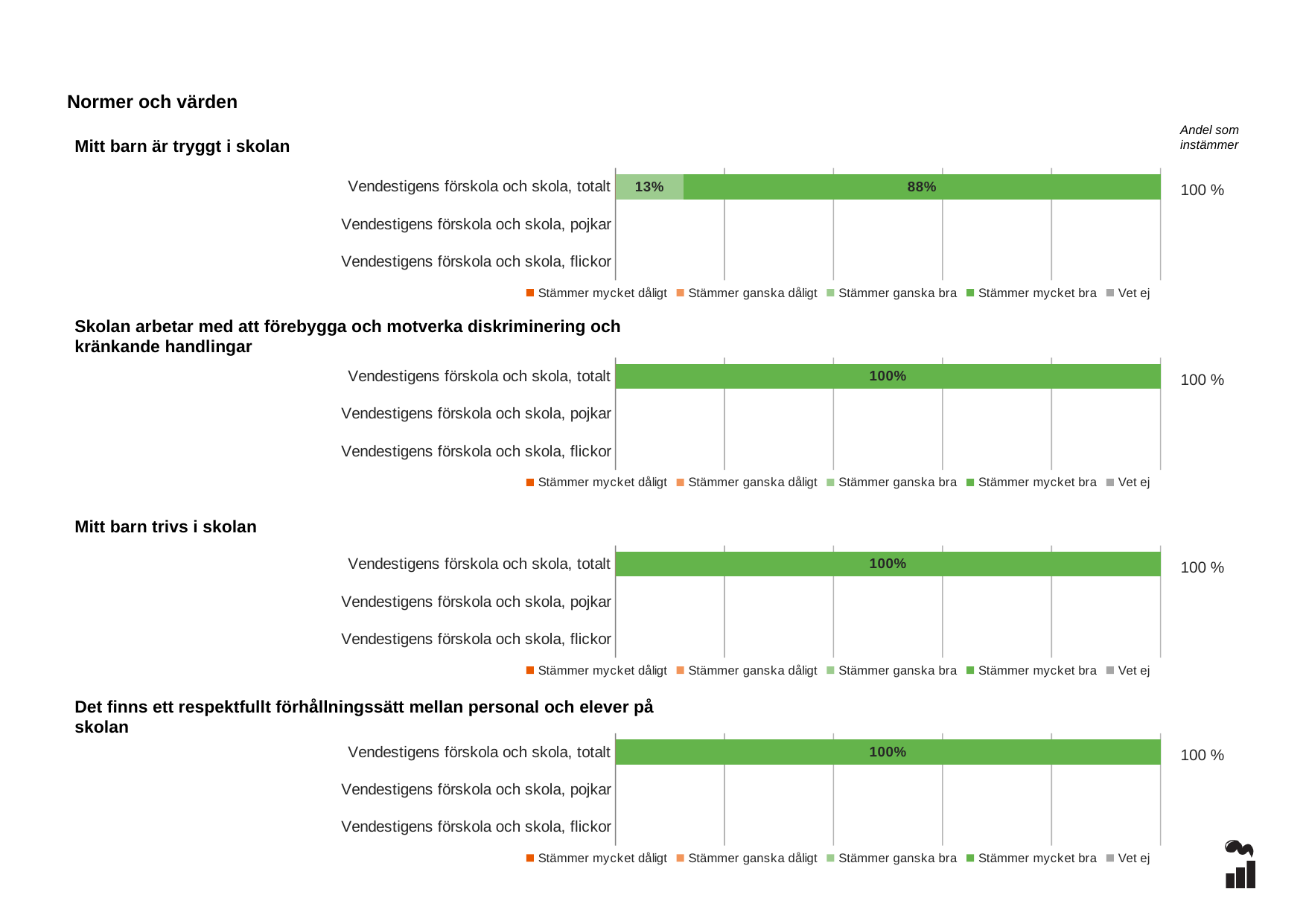
In the chart 'Mitt barn är tryggt i skolan', what is the difference in percentage points between 'Stämmer mycket bra' and 'Stämmer ganska bra' for the 'totalt' row? 75 percentage points In the chart 'Skolan arbetar med att förebygga och motverka diskriminering och kränkande handlingar', what percentage is shown for 'Vendestigens förskola och skola, totalt'? 100% What kind of chart is used for 'Mitt barn trivs i skolan'? Stacked horizontal bar chart In the chart 'Mitt barn trivs i skolan', what percentage is shown for 'Vendestigens förskola och skola, totalt'? 100% In the chart 'Mitt barn är tryggt i skolan', what percentage of 'Vendestigens förskola och skola, totalt' answered 'Stämmer ganska bra'? 13% In the chart 'Mitt barn är tryggt i skolan', for the 'totalt' row, which share is larger: 'Stämmer ganska bra' or 'Stämmer mycket bra'? Stämmer mycket bra How many charts are shown on the slide? 4 In the chart 'Mitt barn är tryggt i skolan', how many response categories does the legend list? 5 In the chart 'Mitt barn är tryggt i skolan', what percentage of 'Vendestigens förskola och skola, totalt' answered 'Stämmer mycket bra'? 88% In the chart 'Det finns ett respektfullt förhållningssätt mellan personal och elever på skolan', what percentage is shown for 'Vendestigens förskola och skola, totalt'? 100% In the chart 'Mitt barn är tryggt i skolan', what is the 'Andel som instämmer' value shown to the right of the 'totalt' bar? 100 % In the chart 'Mitt barn är tryggt i skolan', how many respondent groups (rows) are listed on the vertical axis? 3